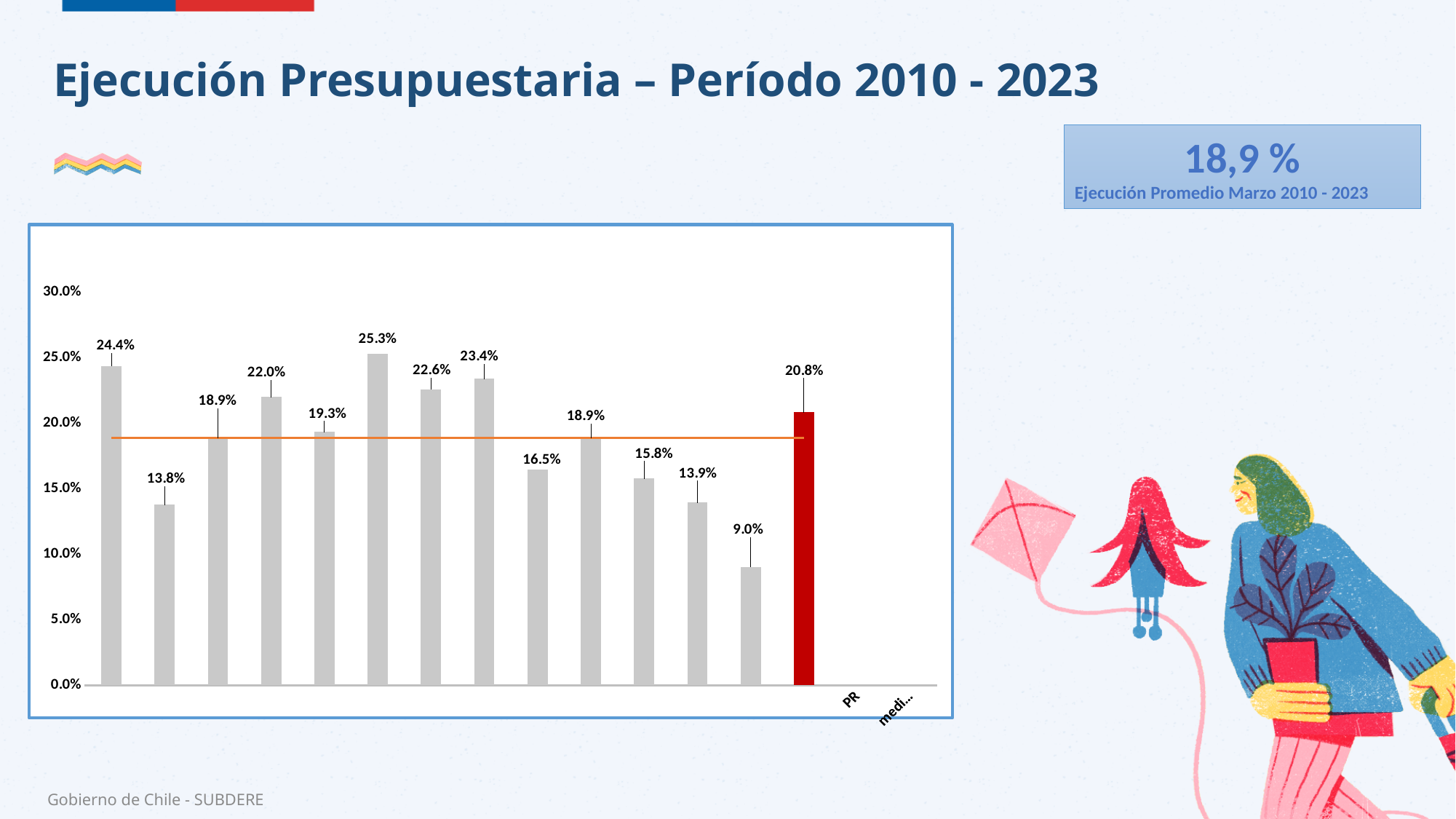
Is the value of the red bar greater or less than 20.0%? greater How many bars are plotted in the chart? 14 What average execution value is shown in the box at the top right of the slide? 18,9 % What type of chart is shown on the slide? Bar chart What value is labelled on the red bar in the chart? 20.8% What colour is the last bar in the chart? Red What value is labelled on the first (leftmost) bar in the chart? 24.4% What is the difference between the highest bar value (25.3%) and the lowest bar value (9.0%)? 16.3 percentage points How many bars in the chart have values above 20.0%? 6 What is the highest value shown by any bar in the chart? 25.3% Which is larger: the first bar (24.4%) or the red bar (20.8%)? The first bar (24.4%) What is the lowest value shown by any bar in the chart? 9.0%